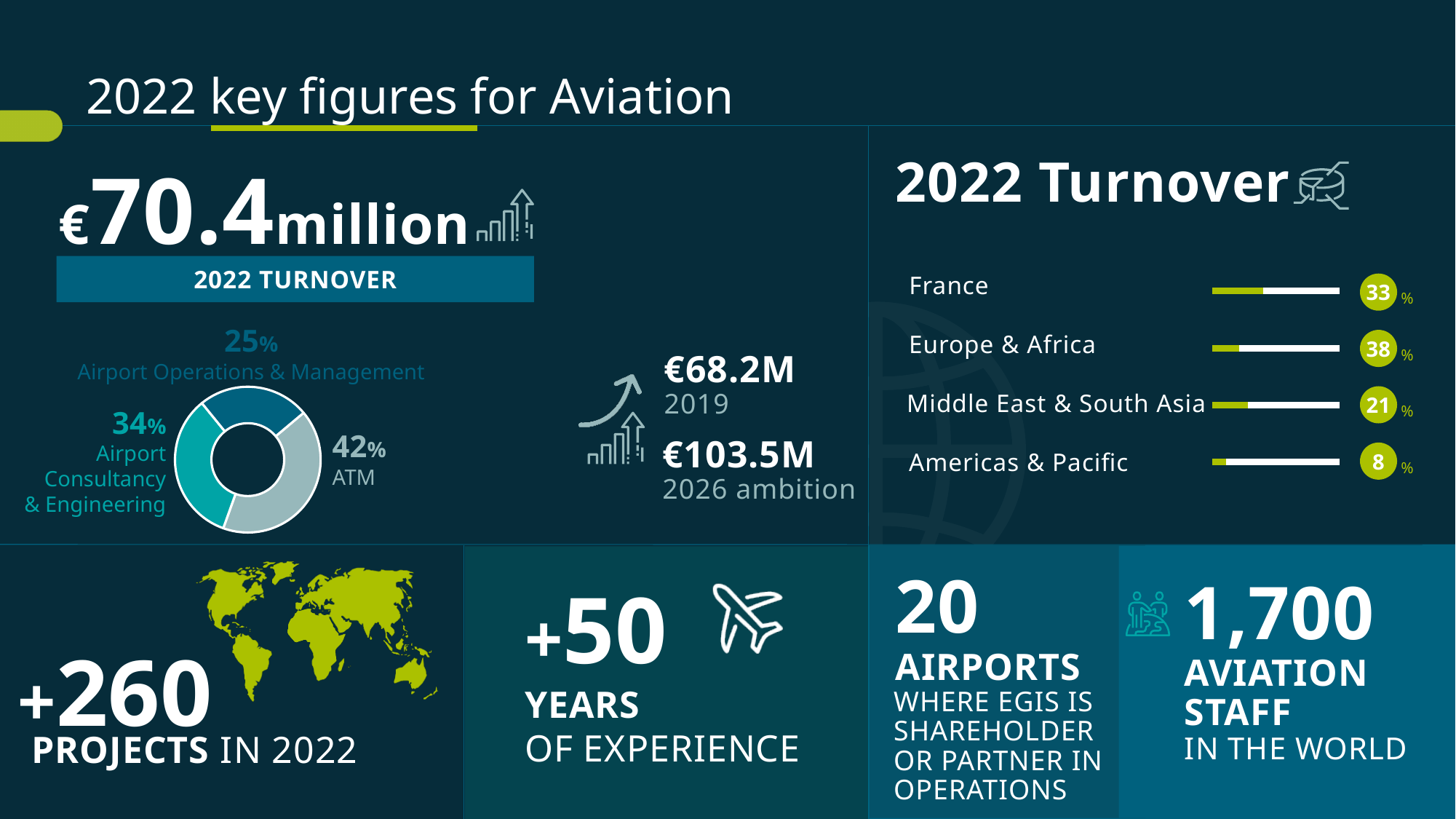
In the donut chart on the left, which segment is the smallest? Airport Operations & Management In the 2022 Turnover chart on the right, which is larger: France or Middle East & South Asia? France In the donut chart on the left, what share is attributed to Airport Consultancy & Engineering? 34% In the donut chart on the left, how many segments are shown? 3 In the donut chart on the left, what share is attributed to Airport Operations & Management? 25% In the donut chart on the left, which segment is the largest? ATM In the donut chart on the left, what is the difference in percentage points between ATM and Airport Consultancy & Engineering? 8 In the 2022 Turnover chart on the right, how many regions are listed? 4 In the 2022 Turnover chart on the right, what is the value for Americas & Pacific? 8% In the 2022 Turnover chart on the right, what is the value for France? 33% In the 2022 Turnover chart on the right, which region has the highest share? Europe & Africa In the donut chart on the left, what share of 2022 turnover comes from ATM? 42%